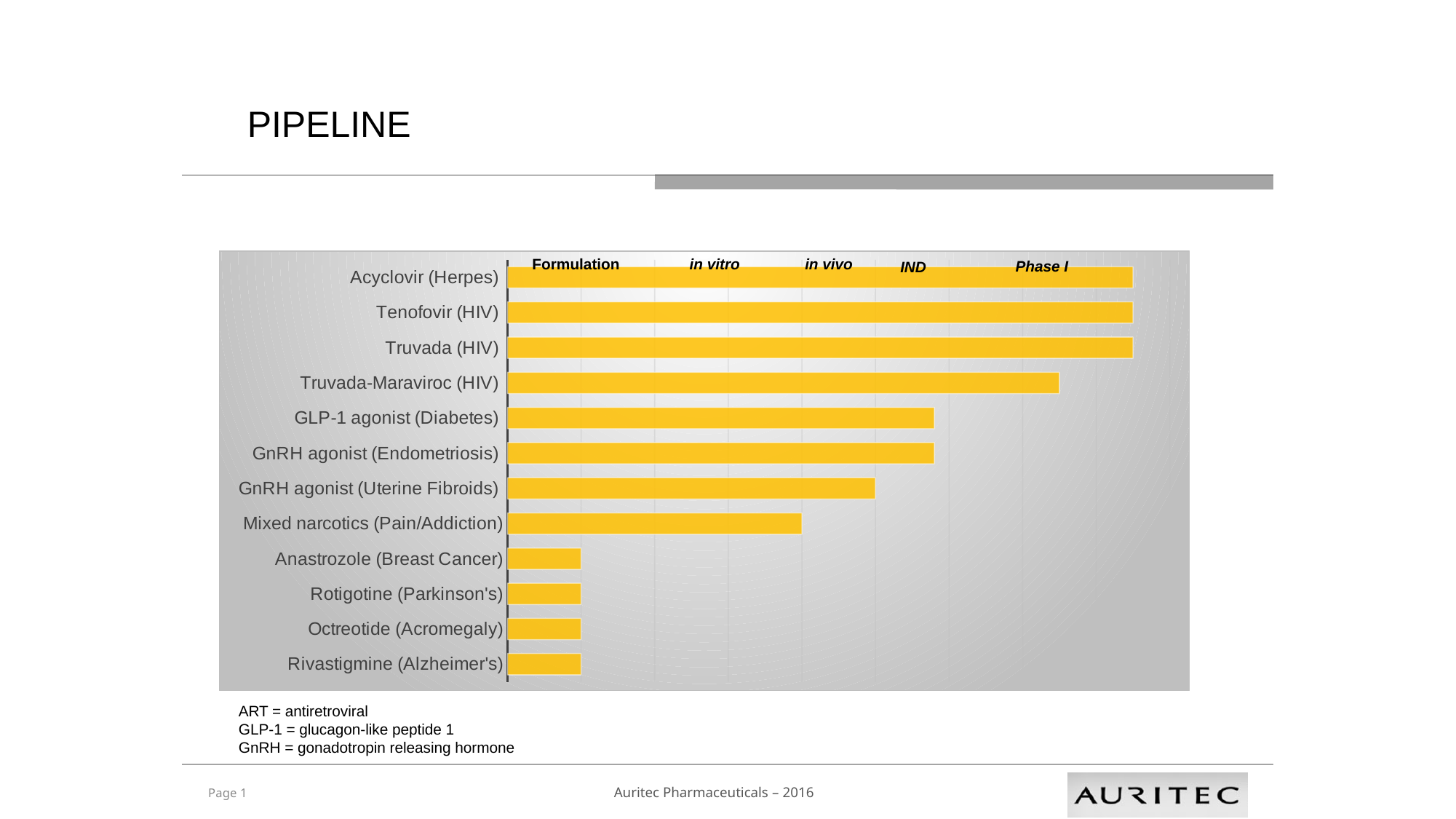
How many drug candidates (categories) are plotted in the chart? 12 Which bar is longer, Mixed narcotics (Pain/Addiction) or Anastrozole (Breast Cancer)? Mixed narcotics (Pain/Addiction) Which bar is longer, Tenofovir (HIV) or Truvada-Maraviroc (HIV)? Tenofovir (HIV) What kind of chart is shown on the slide? bar chart Do the bars get longer or shorter going from the top category to the bottom category? shorter Which bar is longer, GLP-1 agonist (Diabetes) or Mixed narcotics (Pain/Addiction)? GLP-1 agonist (Diabetes) Which development stage label appears furthest to the right along the top of the chart? Phase I What is the title of the slide containing the chart? PIPELINE